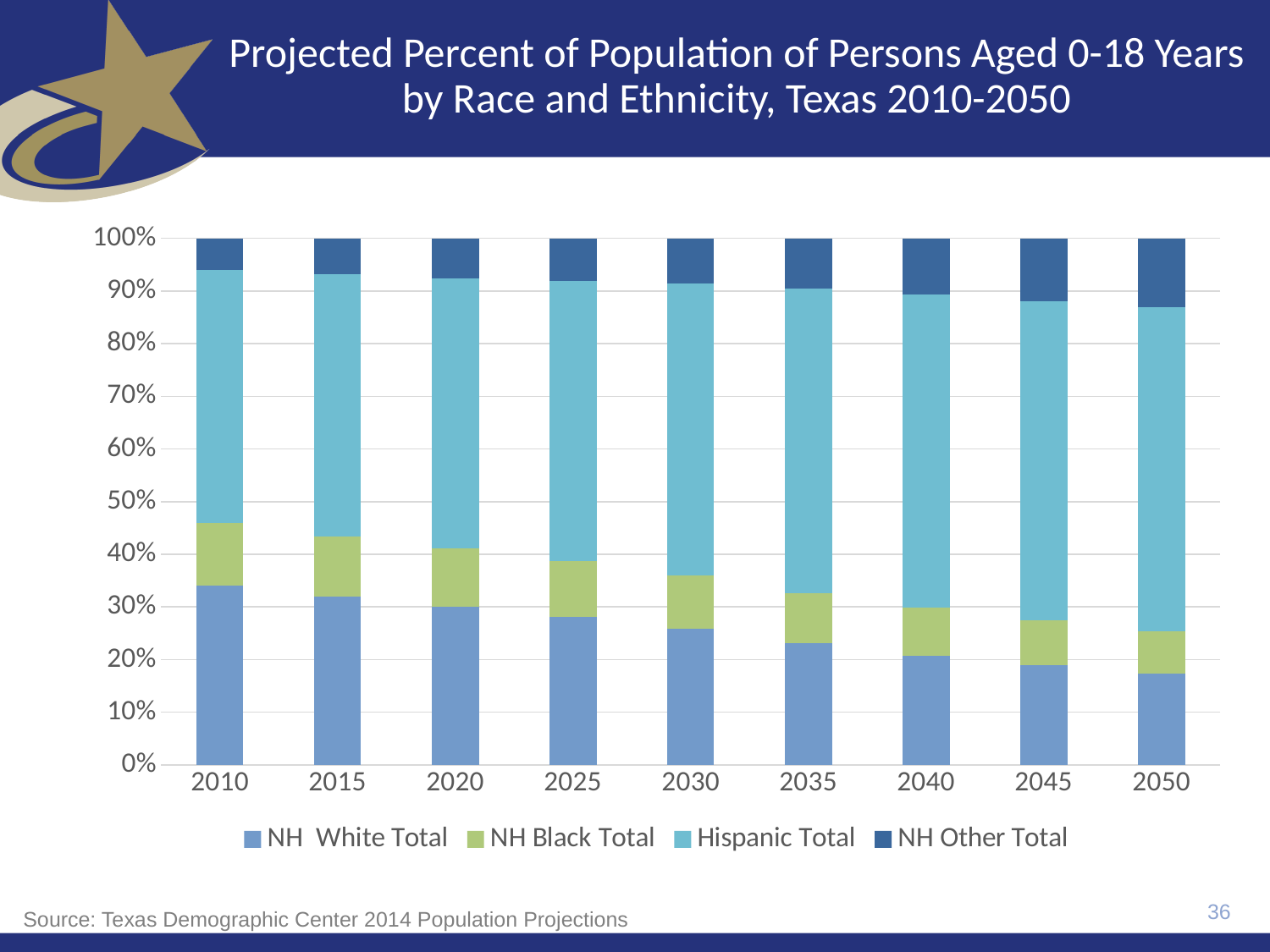
Is the NH White Total value for 2050 greater or less than 20%? less Is the NH White Total value for 2010 greater or less than 30%? greater Which legend entry is shown in green? NH Black Total How many years are shown along the x axis of the chart? 9 Which year has the lowest NH White Total share? 2050 Does the Hispanic Total share rise or fall from 2010 to 2050? rise Which is larger, the Hispanic Total share in 2010 or in 2050? 2050 Which year has the highest NH White Total share? 2010 Does the NH White Total share rise or fall from 2010 to 2050? fall What kind of chart is shown on the slide? Stacked bar chart How many series does the chart's legend list? 4 What is the total of the stacked bar for 2030? 100%